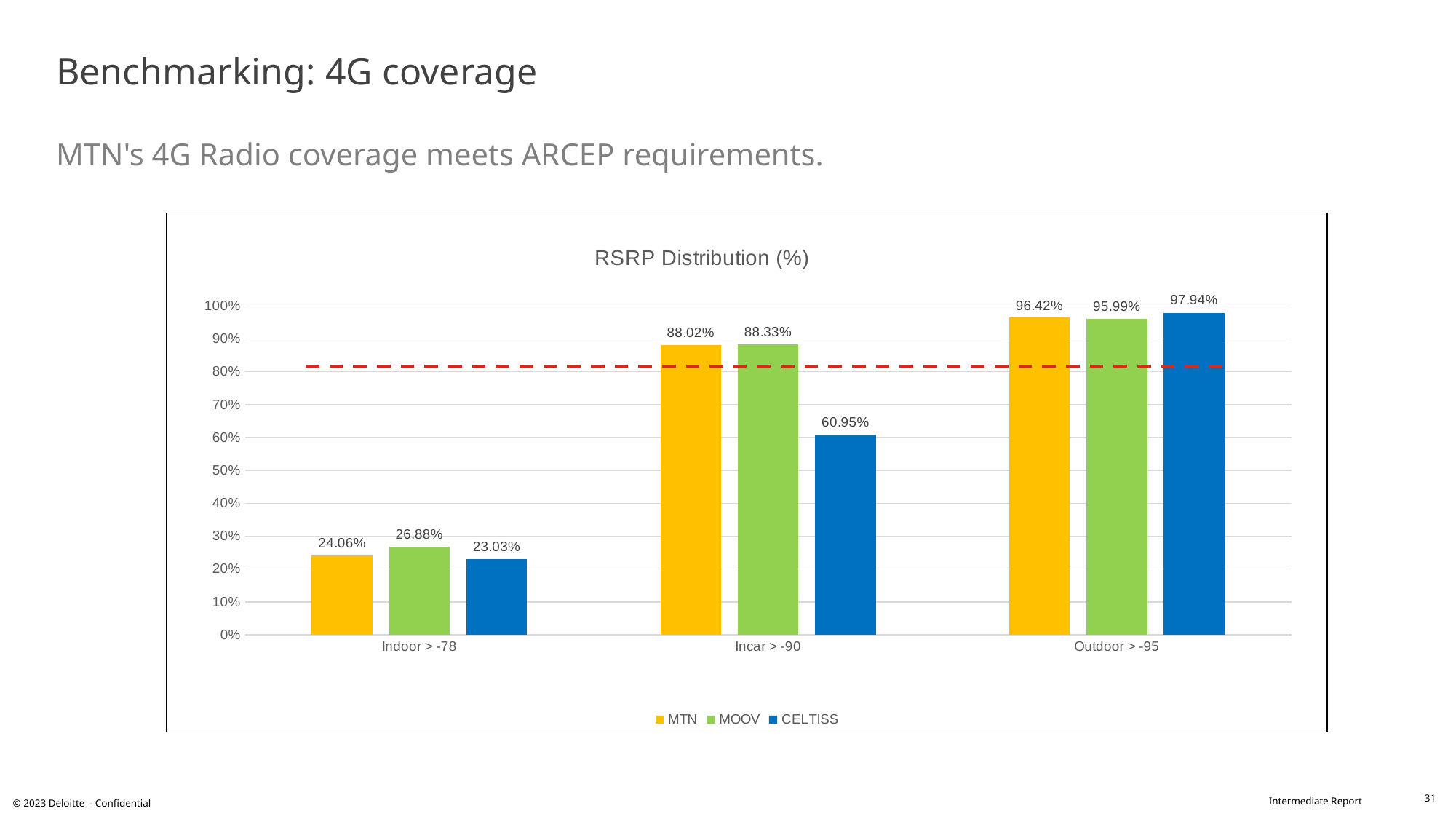
How many categories are shown on the x axis? 3 What is the value for MOOV in the Outdoor > -95 category? 95.99% Which operator has the lowest value in the Indoor > -78 category? CELTISS What is the difference between MOOV and CELTISS in the Incar > -90 category? 27.38% What is the title of the chart? RSRP Distribution (%) Which is larger in the Indoor > -78 category, MTN or MOOV? MOOV What kind of chart is shown on the slide? bar chart Is the value for CELTISS in the Incar > -90 category greater or less than 70%? less What is the value for CELTISS in the Incar > -90 category? 60.95% Which operator has the highest value in the Outdoor > -95 category? CELTISS What is the value for MTN in the Indoor > -78 category? 24.06% How many series does the legend list? 3